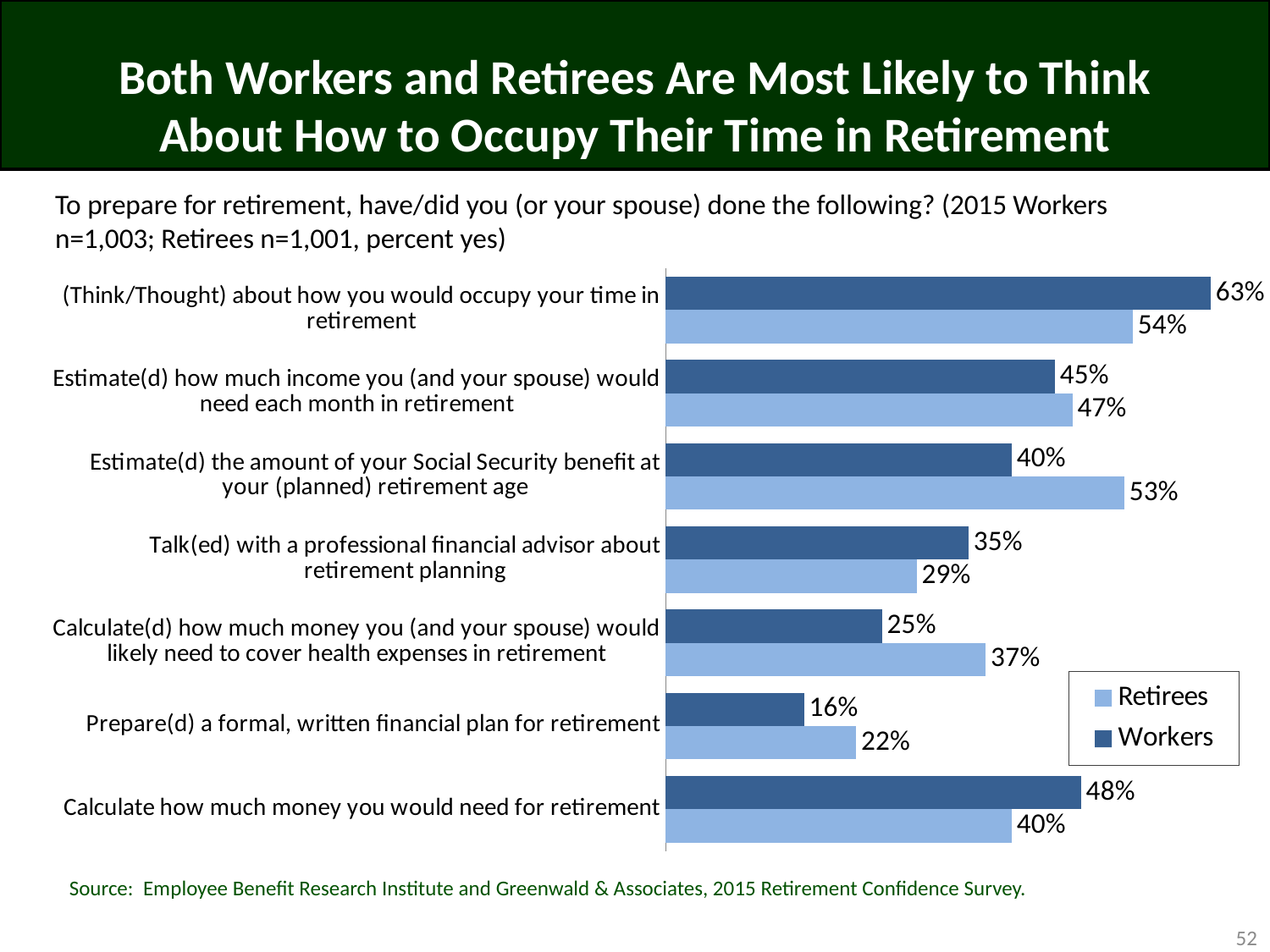
Which series is shown in the darker blue colour? Workers What type of chart is shown on the slide? Bar chart What percentage of Workers said they have thought about how they would occupy their time in retirement? 63% How many series does the legend list? 2 How many activities (categories) are shown in the chart? 7 For talking with a professional financial advisor about retirement planning, which group has the higher percentage, Workers or Retirees? Workers What percentage of Retirees estimated the amount of their Social Security benefit at their planned retirement age? 53% For estimating how much income would be needed each month in retirement, which group has the higher percentage, Workers or Retirees? Retirees Which activity has the highest percentage for Workers? (Think/Thought) about how you would occupy your time in retirement What is the difference between the Retirees and Workers percentages for calculating how much money would likely be needed to cover health expenses in retirement? 12 percentage points Which activity has the lowest percentage for Retirees? Prepare(d) a formal, written financial plan for retirement What percentage of Retirees prepared a formal, written financial plan for retirement? 22%